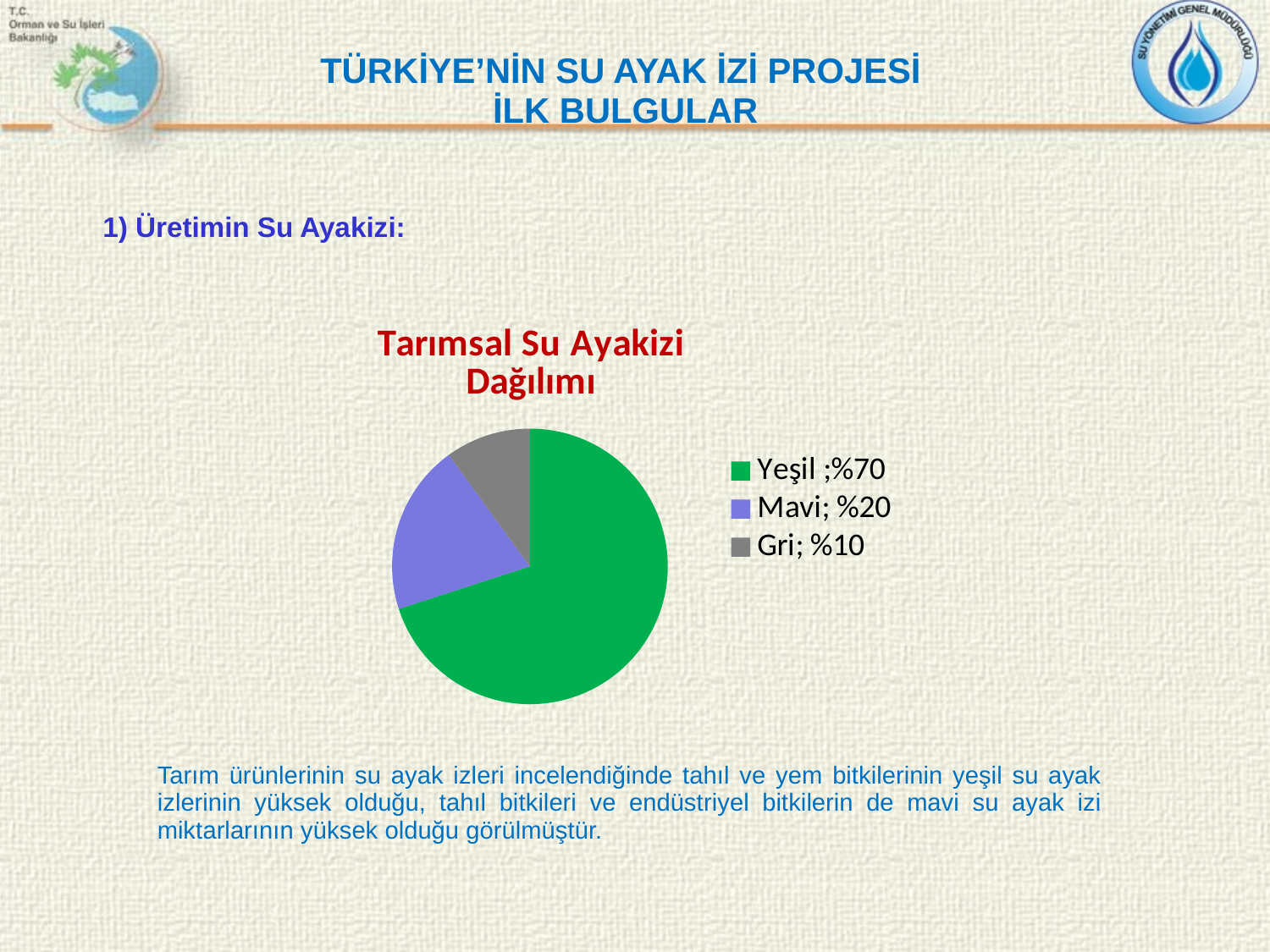
What is the title of the pie chart? Tarımsal Su Ayakizi Dağılımı What share of the pie does Gri have? %10 What is the difference between the Yeşil and Mavi shares? %50 What kind of chart is shown on the slide? pie chart What colour is the Gri slice in the pie chart? grey Which slice of the pie chart is the largest? Yeşil What is the difference between the Mavi and Gri shares? %10 Which is larger, the Mavi share or the Gri share? Mavi What share of the pie does Yeşil have? %70 Which slice of the pie chart is the smallest? Gri How many slices does the pie chart have? 3 What share of the pie does Mavi have? %20